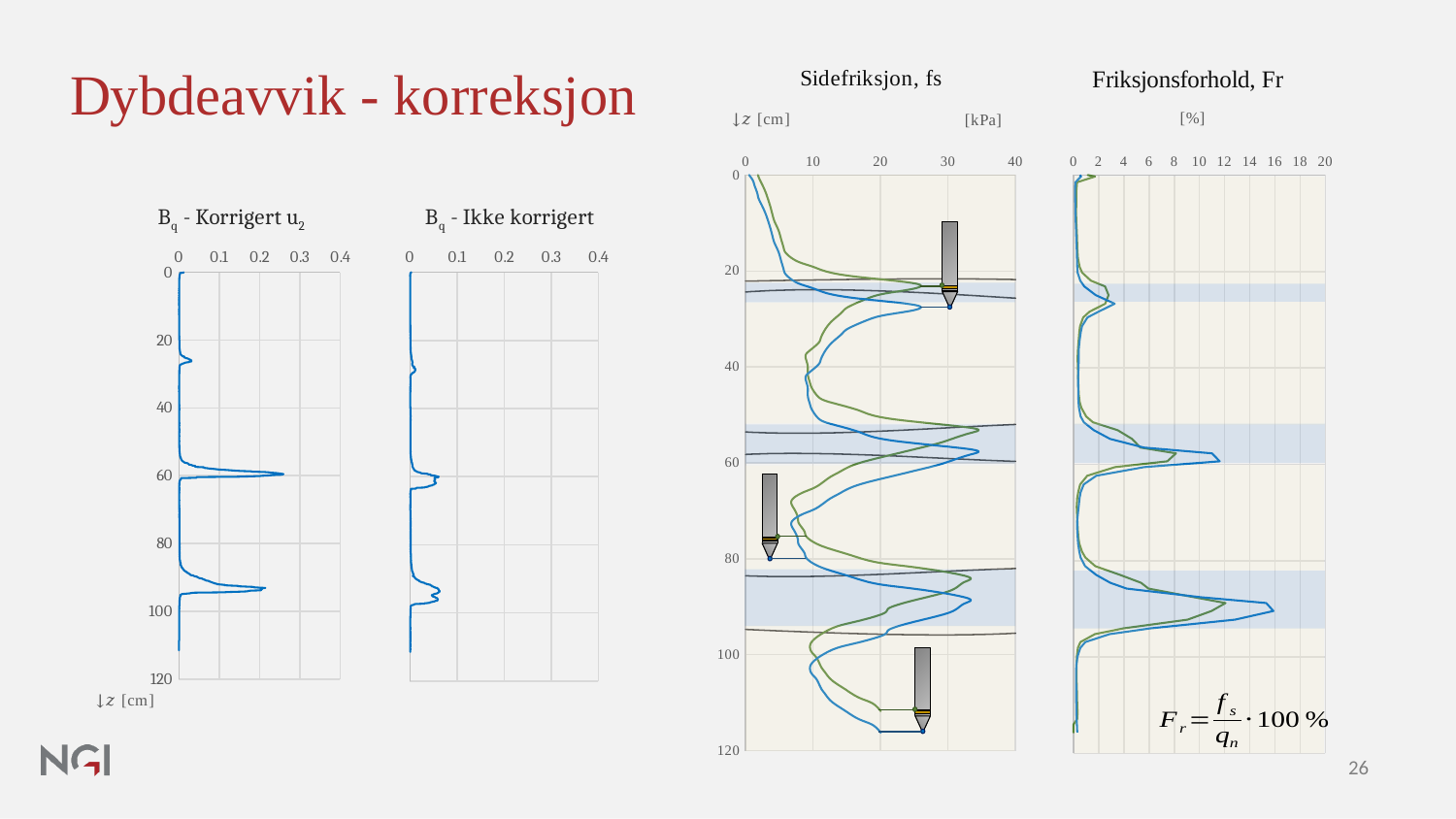
In the 'Bq - Ikke korrigert' chart, is the peak value near a depth of 60 cm greater or less than 0.1? less In the 'Bq - Korrigert u2' chart, is the peak value near a depth of 60 cm greater or less than 0.2? greater In the 'Bq - Korrigert u2' chart, which peak is larger: the one near 60 cm depth or the one near 95 cm depth? the one near 60 cm In the 'Friksjonsforhold, Fr' chart, is the blue line's peak near a depth of 60 cm greater or less than 10? greater What unit is shown for the horizontal axis of the 'Friksjonsforhold, Fr' chart? % In the 'Friksjonsforhold, Fr' chart, which blue-line peak is larger: the one near 60 cm depth or the one near 90 cm depth? the one near 90 cm What kind of chart is the 'Sidefriksjon, fs' chart? line chart What is the maximum value shown on the horizontal axis of the 'Sidefriksjon, fs' chart? 40